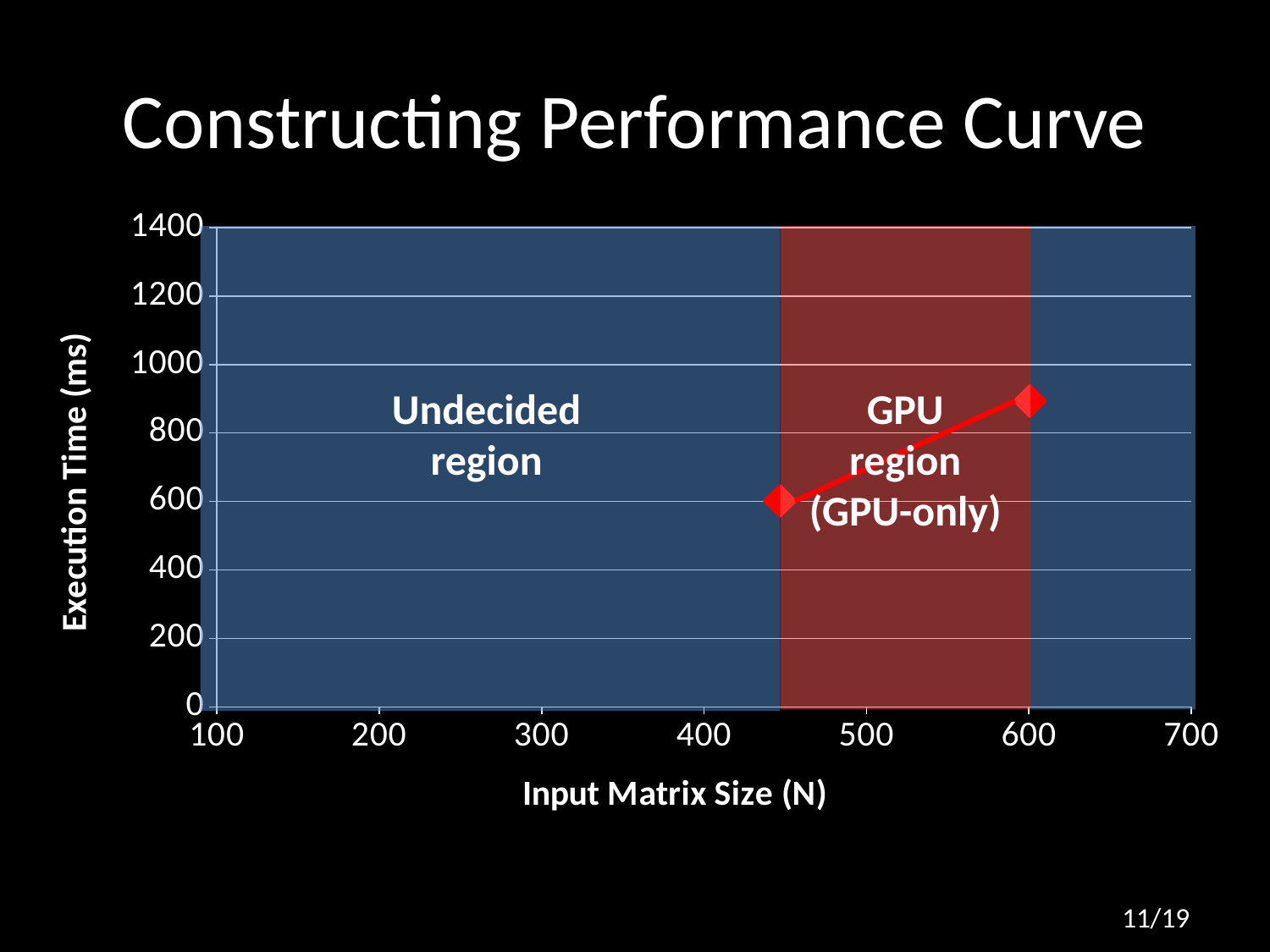
Is the execution time for the leftmost data point greater or less than 800 ms? less What kind of chart is shown on the slide? line chart How many data points are plotted on the line? 2 What is the title of the chart's x axis? Input Matrix Size (N) What is the maximum value shown on the y axis? 1400 Is the execution time for the rightmost data point greater or less than 800 ms? greater Does the execution time rise or fall as the input matrix size increases? rise Is the execution time for the rightmost data point greater or less than 1000 ms? less Which data point has the higher execution time, the one at the smaller input matrix size or the one at the larger input matrix size? the one at the larger input matrix size What is the title of the chart's y axis? Execution Time (ms)